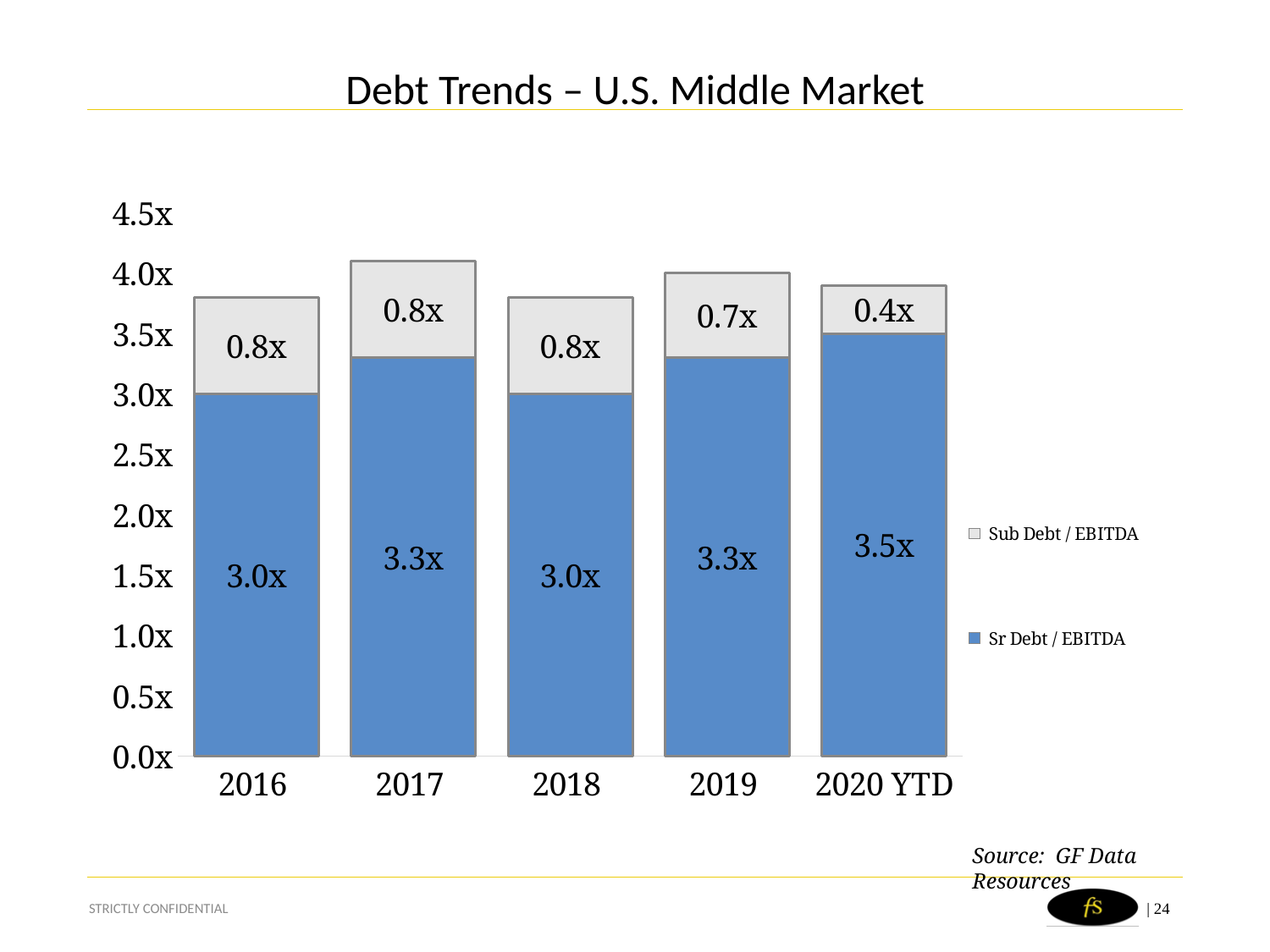
What is the Sr Debt / EBITDA value for 2017? 3.3x What is the total of the stacked bar for 2019? 4.0x Which is larger, the Sub Debt / EBITDA value for 2018 or for 2020 YTD? 2018 What is the difference between the Sr Debt / EBITDA values for 2020 YTD and 2016? 0.5x What kind of chart is shown on the slide? Stacked bar chart How many series does the legend list? 2 What is the total of the stacked bar for 2017? 4.1x How many years are shown on the x axis? 5 What is the Sr Debt / EBITDA value for 2020 YTD? 3.5x Which year has the highest Sr Debt / EBITDA value? 2020 YTD What is the Sub Debt / EBITDA value for 2019? 0.7x Which year has the lowest Sub Debt / EBITDA value? 2020 YTD